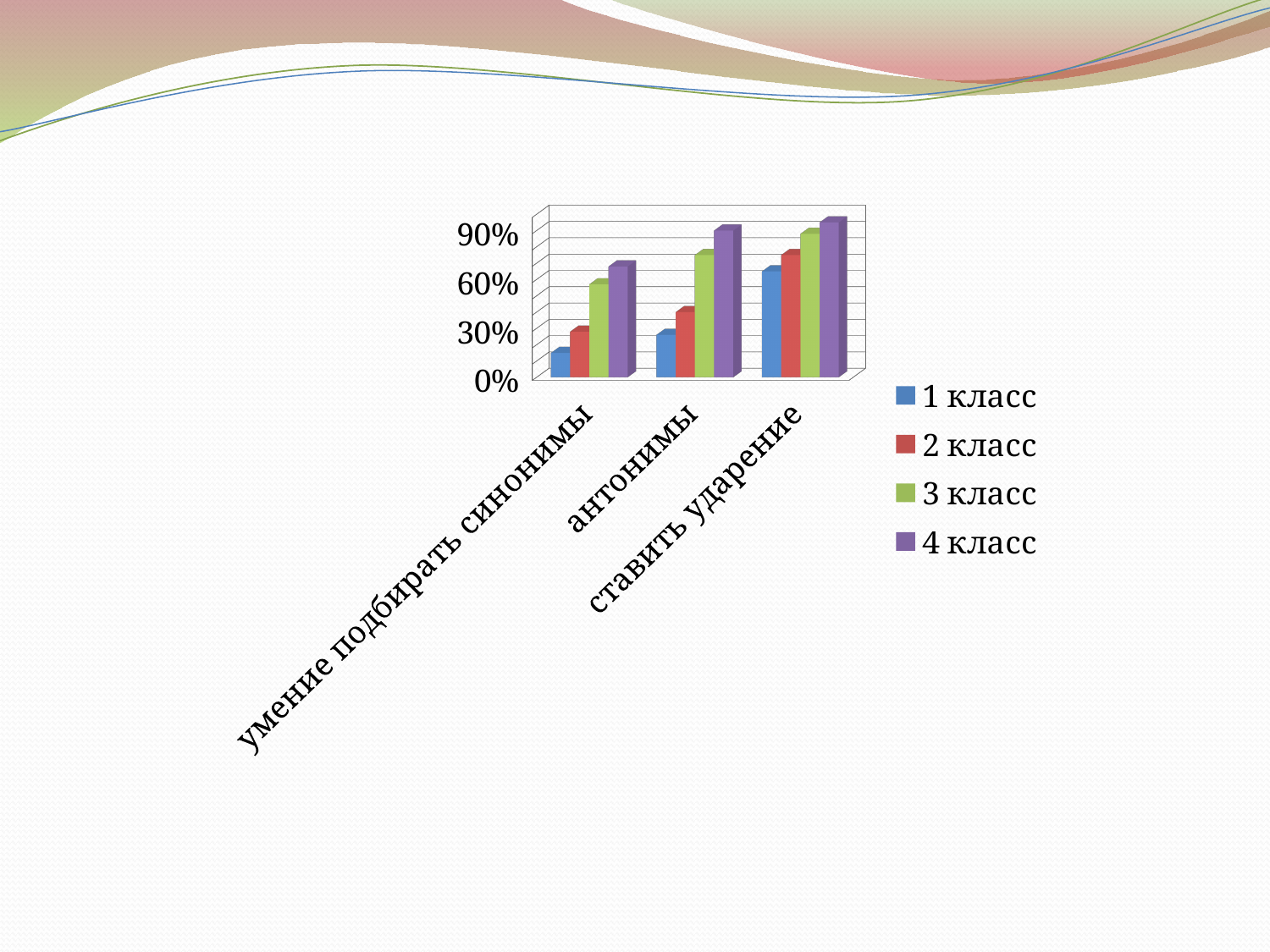
Which series has the lowest value in the category умение подбирать синонимы? 1 класс Which is larger: the value for 4 класс in умение подбирать синонимы or the value for 3 класс in антонимы? 3 класс in антонимы How many categories are shown on the x axis of the chart? 3 What kind of chart is shown on the slide? bar chart Which series has the highest value in the category антонимы? 4 класс Is the value for 2 класс in антонимы greater or less than 30%? greater Which series is shown in purple in the legend? 4 класс Within the category ставить ударение, do the values rise or fall from 1 класс to 4 класс? rise How many series does the chart's legend list? 4 Is the value for 1 класс in умение подбирать синонимы greater or less than 30%? less Is the value for 4 класс in антонимы greater or less than 60%? greater Which category has the highest value for 1 класс? ставить ударение